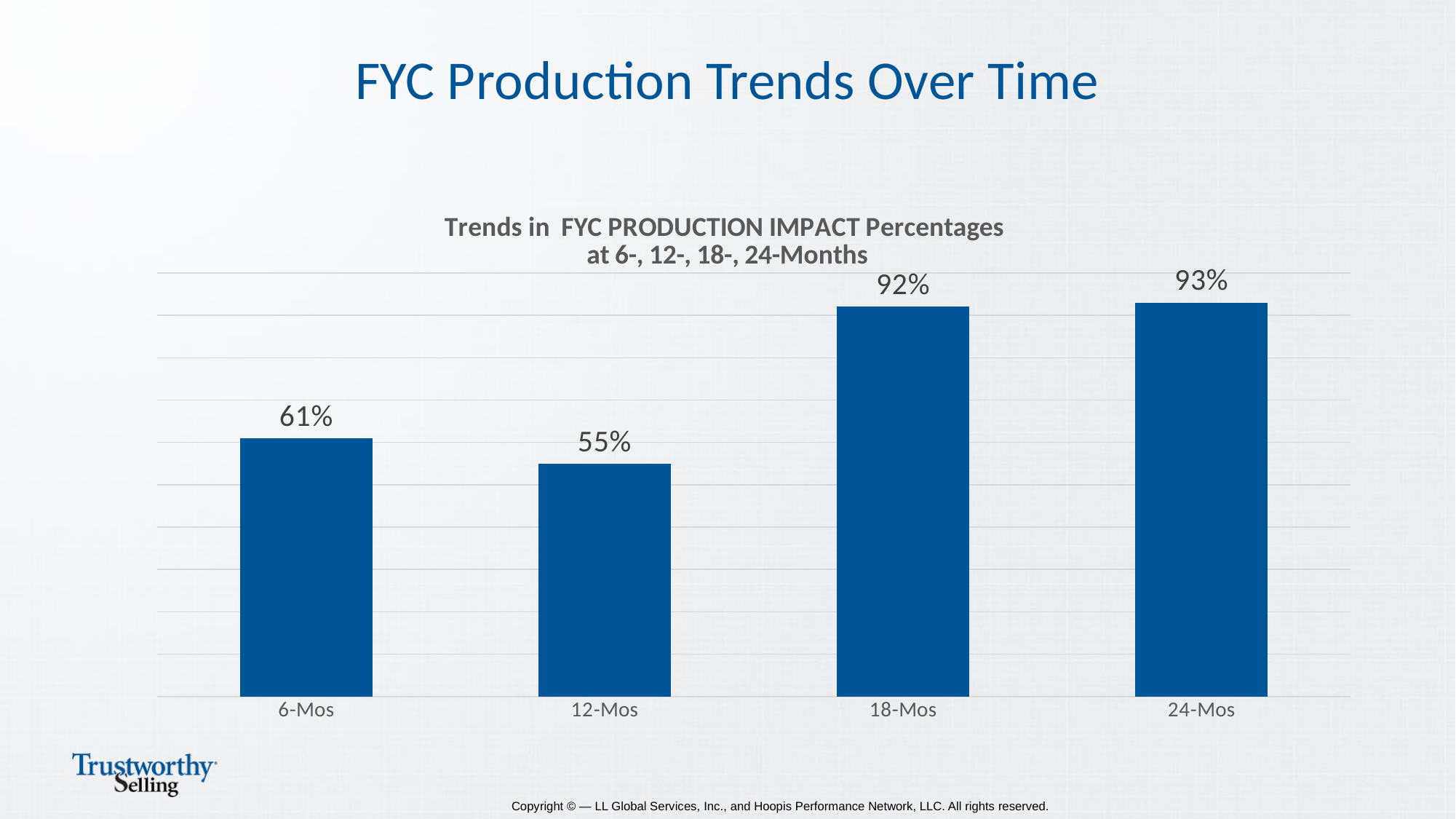
Which category has the lowest value? 12-Mos How many categories are shown on the x axis? 4 What is the value for 12-Mos? 55% What is the difference between the values for 18-Mos and 12-Mos? 37% What is the value for 18-Mos? 92% Do the values rise or fall from 12-Mos to 24-Mos? Rise What is the value for 24-Mos? 93% Which is larger, the value for 6-Mos or the value for 12-Mos? 6-Mos What kind of chart is shown on the slide? Bar chart What is the title of the chart? Trends in FYC PRODUCTION IMPACT Percentages at 6-, 12-, 18-, 24-Months What is the difference between the values for 6-Mos and 12-Mos? 6% What is the value for 6-Mos? 61%